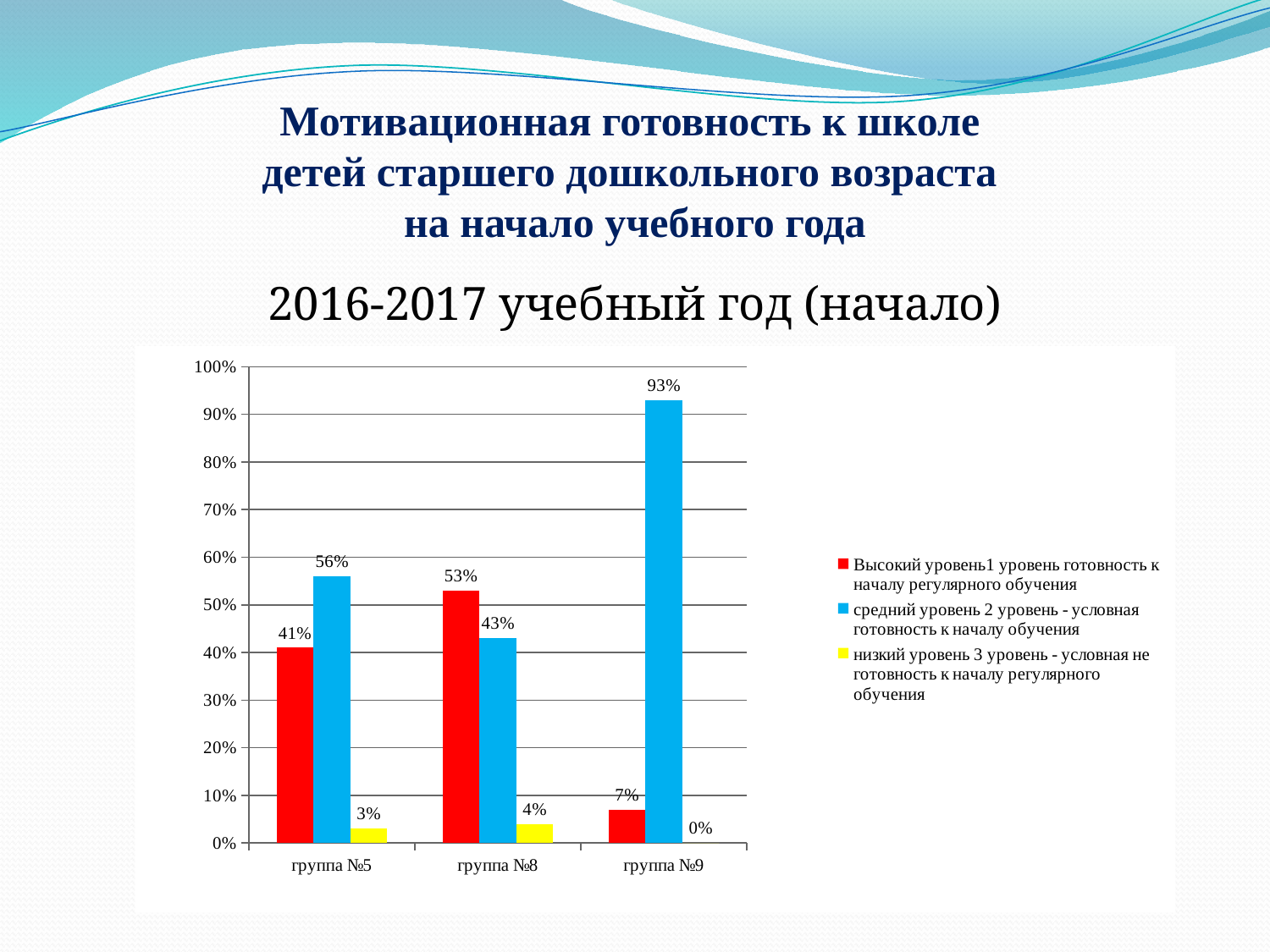
What is the value of the medium level (средний уровень) series for группа №9? 93% What colour represents the low level (низкий уровень) series? yellow Which is larger for группа №8: the high level value or the medium level value? the high level value (53%) What kind of chart is shown on the slide? bar chart What is the total of the three series values for группа №9? 100% Which group has the highest value for the medium level (средний уровень) series? группа №9 What is the difference between the medium level value for группа №5 and the high level value for группа №5? 15% What is the value of the high level (Высокий уровень) series for группа №8? 53% How many series does the legend list? 3 Which group has the lowest value for the high level (Высокий уровень) series? группа №9 What is the value of the low level (низкий уровень) series for группа №5? 3% How many groups are shown on the x axis? 3